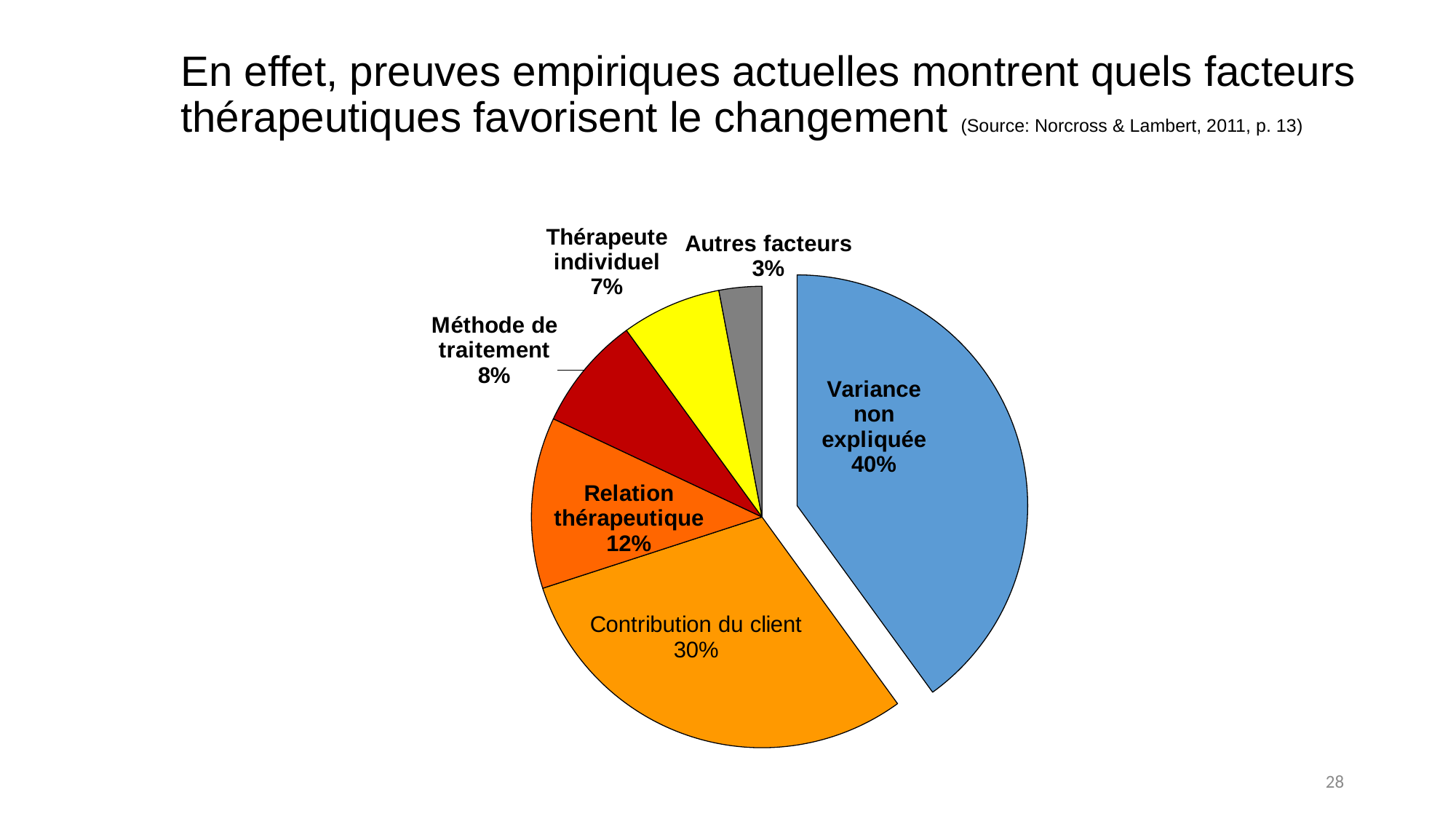
Which slice of the pie is the largest? Variance non expliquée Which slice of the pie is the smallest? Autres facteurs How many slices does the pie chart have? 6 Which is larger, "Méthode de traitement" or "Thérapeute individuel"? Méthode de traitement What kind of chart is shown on the slide? pie chart What percentage is shown for "Relation thérapeutique"? 12% What percentage is shown for "Thérapeute individuel"? 7% What is the difference in percentage points between "Contribution du client" and "Relation thérapeutique"? 18 What share of the pie is labelled "Variance non expliquée"? 40% Which slice of the pie is pulled out (exploded) from the rest? Variance non expliquée What percentage is shown for "Méthode de traitement"? 8% What percentage is shown for "Contribution du client"? 30%